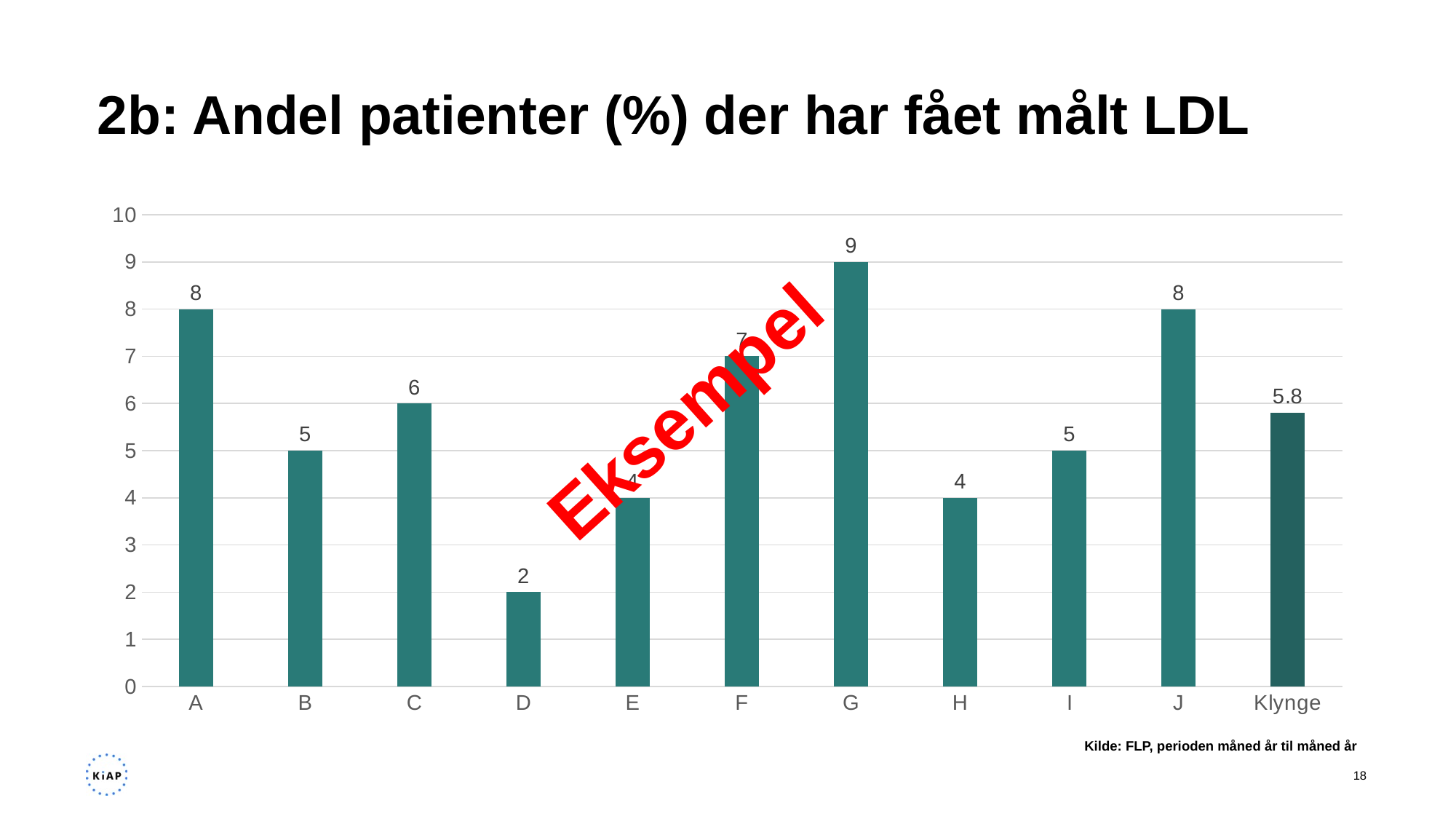
Is the value for J greater or less than 5? greater What is the difference between the values for G and D? 7 Which category has the lowest value? D Which category has the highest value? G How many categories are shown on the x axis? 11 What is the value for category I? 5 What is the value for category A? 8 What is the title of the slide? 2b: Andel patienter (%) der har fået målt LDL What kind of chart is shown? bar chart What is the value for category D? 2 What is the value for Klynge? 5.8 Which is larger, the value for C or the value for H? C